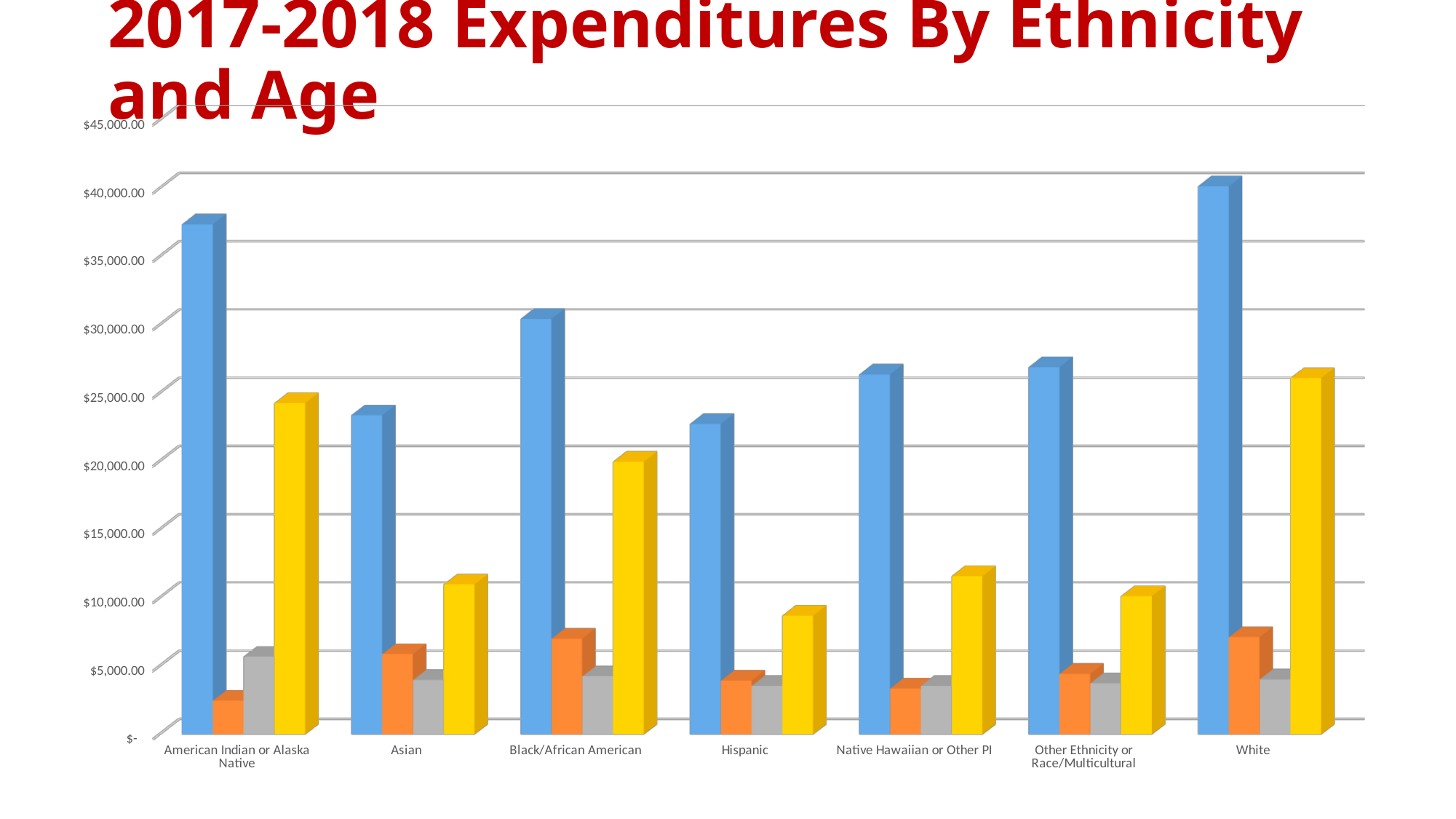
Is the blue bar for Asian greater or less than $25,000.00? less Is the blue bar for Black/African American greater or less than $25,000.00? greater Is the orange bar for Black/African American greater or less than $10,000.00? less Which is larger, the blue bar for American Indian or Alaska Native or the blue bar for Black/African American? American Indian or Alaska Native What is the title of the chart on the slide? 2017-2018 Expenditures By Ethnicity and Age How many ethnicity categories are shown along the x axis? 7 Which is larger, the yellow bar for Black/African American or the yellow bar for Asian? Black/African American Which ethnicity category has the tallest blue bar? White What kind of chart is shown on the slide? bar chart Which ethnicity category has the shortest yellow bar? Hispanic